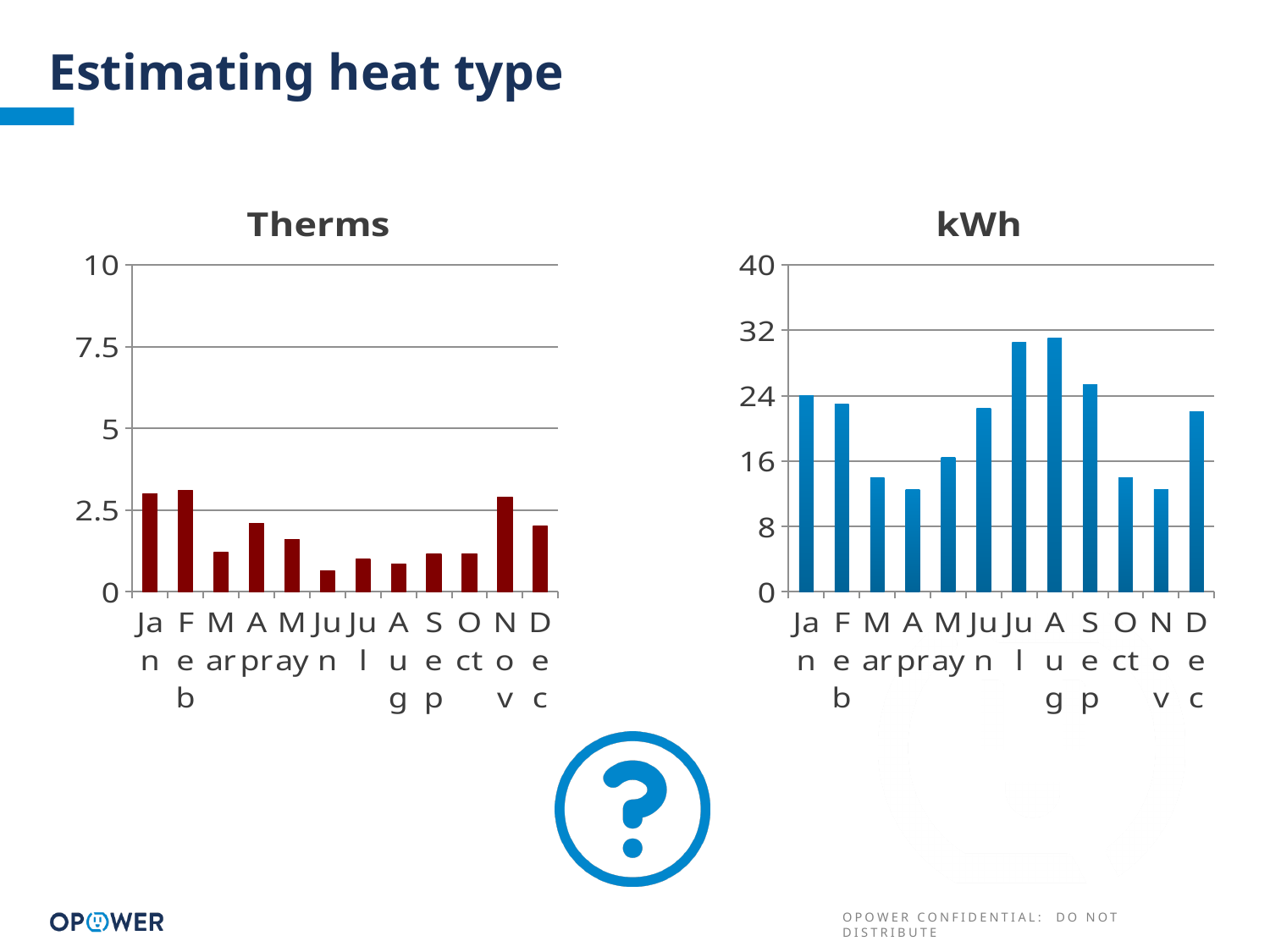
On the kWh chart, is the value for Apr greater or less than 16? less On the Therms chart, which is larger, the value for Apr or the value for Jul? Apr On the kWh chart, is the value for Jul greater or less than 24? greater What kind of chart is the Therms chart? bar chart On the kWh chart, which is larger, the value for Jul or the value for Mar? Jul How many months are shown on the kWh chart? 12 On the Therms chart, is the value for Feb greater or less than 2.5? greater On the kWh chart, which is larger, the value for May or the value for Aug? Aug What is the title of the chart on the right side of the slide? kWh On the Therms chart, which month has the lowest value? Jun